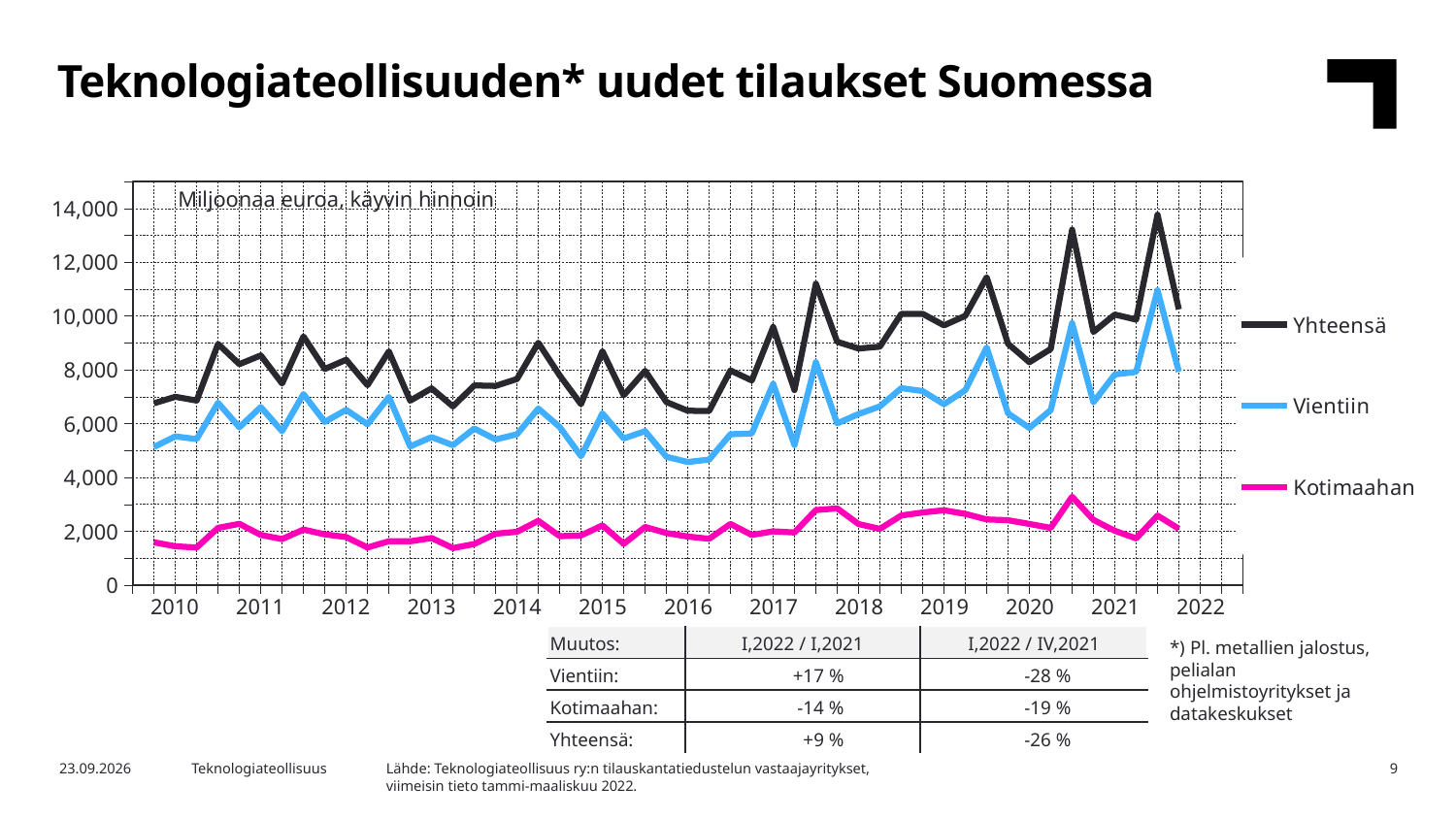
Is the peak value of the Vientiin series in late 2021 greater or less than 10,000? greater What are the three series named in the chart legend? Yhteensä, Vientiin, Kotimaahan Is the value for Yhteensä at the start of 2010 greater or less than 8,000? less Which series has the highest values throughout the chart? Yhteensä How many series does the chart legend list? 3 Is the peak value of the Yhteensä series in late 2021 greater or less than 12,000? greater What unit label is printed inside the chart area? Miljoonaa euroa, käyvin hinnoin How many year labels are shown on the x axis? 13 Which is larger at the start of 2016, the Vientiin value or the Kotimaahan value? Vientiin Which series has the lowest values throughout the chart? Kotimaahan What kind of chart is shown on the slide? line chart